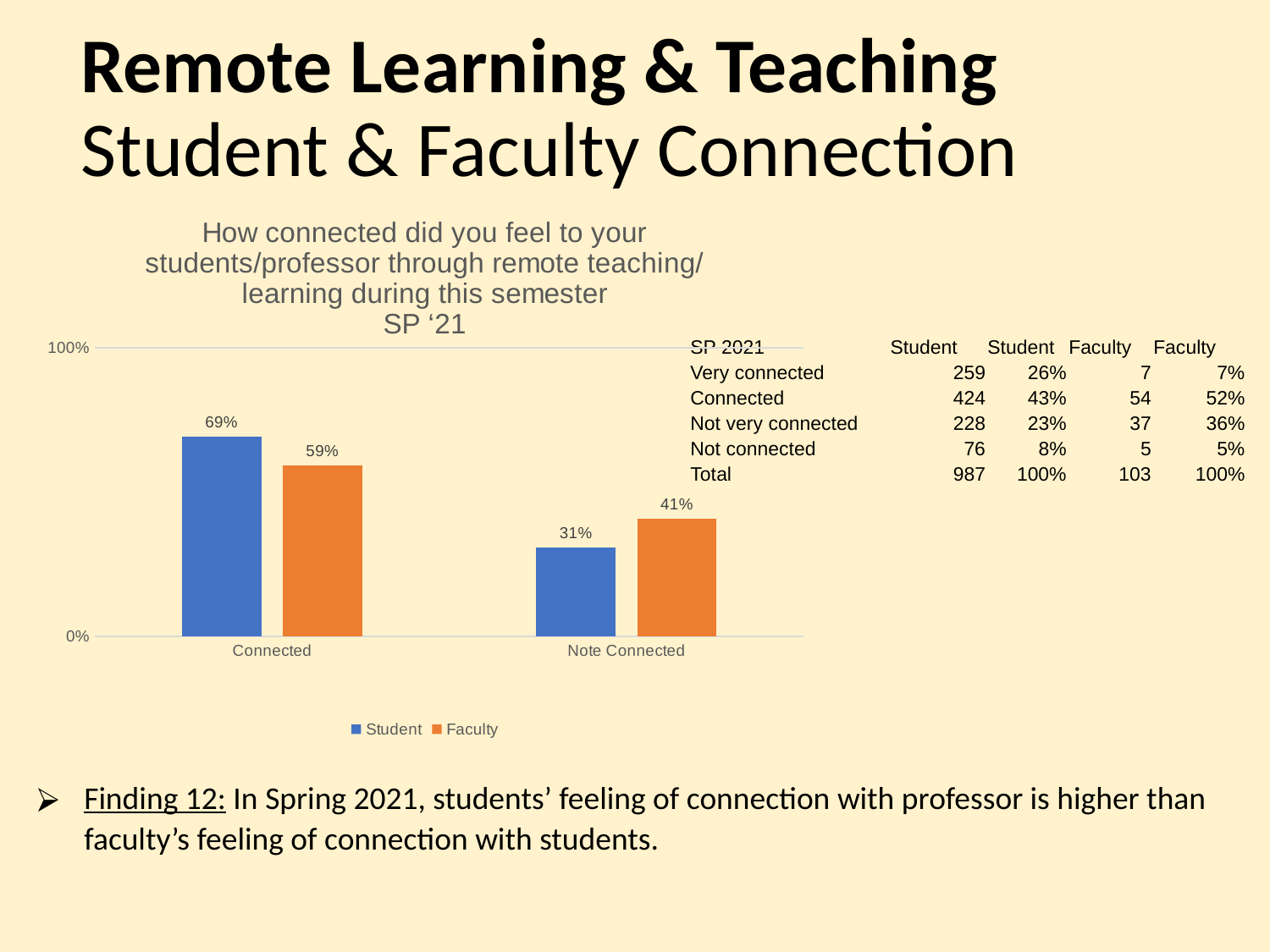
What is the difference between the Student and Faculty values in the Connected category? 10% What is the Faculty value for the Connected category? 59% How many categories are shown on the x axis of the chart? 2 What is the Student value for the Note Connected category? 31% What is the Student value for the Connected category? 69% How many series does the chart legend list? 2 What is the Faculty value for the Note Connected category? 41% What type of chart is shown on the slide? Bar chart Which series has the higher value in the Note Connected category, Student or Faculty? Faculty Which series has the higher value in the Connected category, Student or Faculty? Student Which bar in the chart has the lowest value? Student, Note Connected (31%) What is the difference between the Faculty and Student values in the Note Connected category? 10%